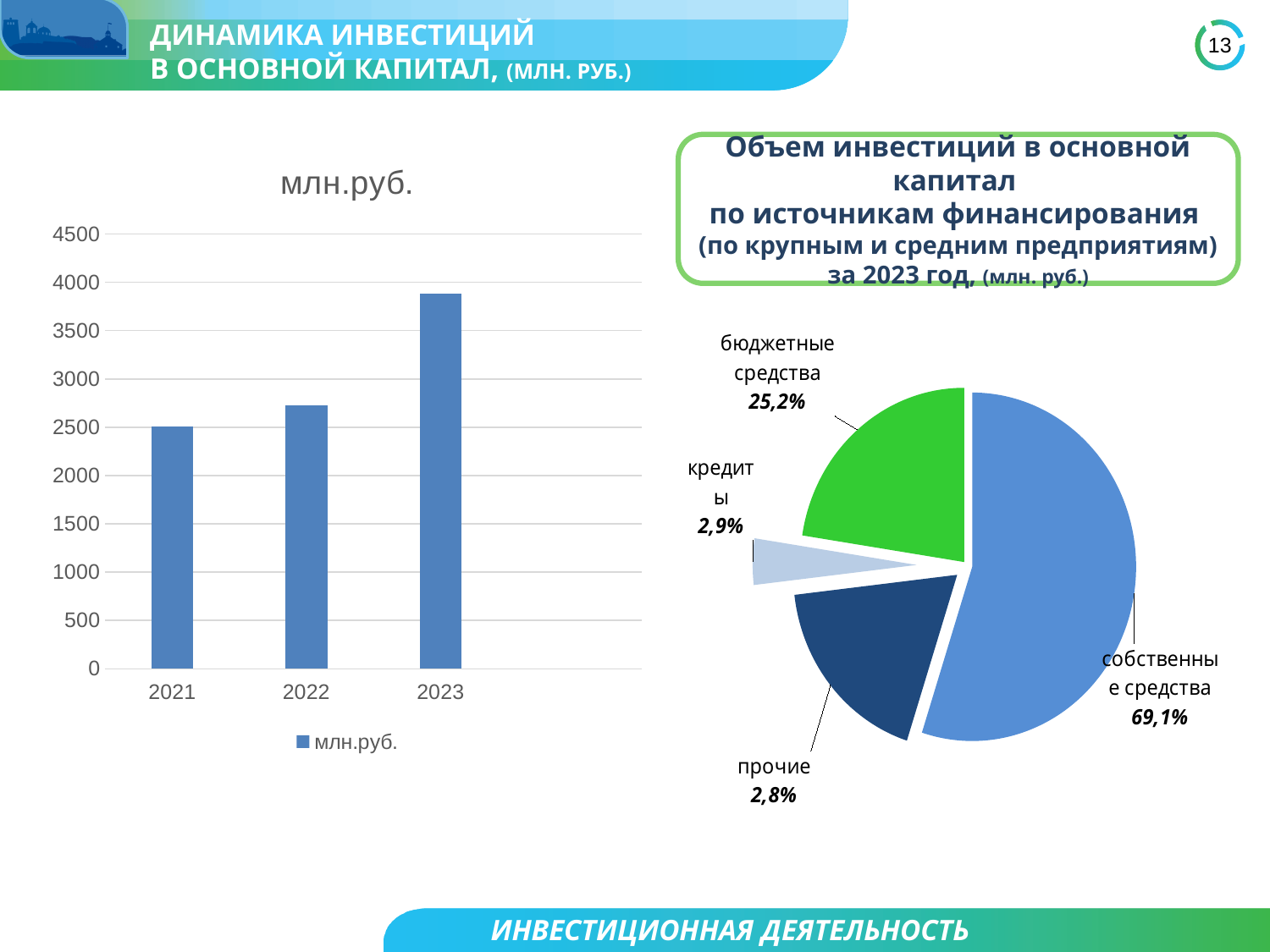
On the bar chart on the left, how many years are shown on the x axis? 3 On the pie chart on the right, what share is labelled for собственные средства? 69,1% On the bar chart on the left, is the value for 2022 greater or less than 3000? less On the bar chart on the left, which year has the lowest value? 2021 On the pie chart on the right, what share is labelled for бюджетные средства? 25,2% On the pie chart on the right, what is the difference between the shares of собственные средства and бюджетные средства? 43,9% On the bar chart on the left, is the value for 2023 greater or less than 3500? greater On the bar chart on the left, do the values rise or fall from 2021 to 2023? rise What kind of chart is the chart on the left of the slide? bar chart On the bar chart on the left, which year has the highest value? 2023 On the bar chart on the left, how many series does the legend list? 1